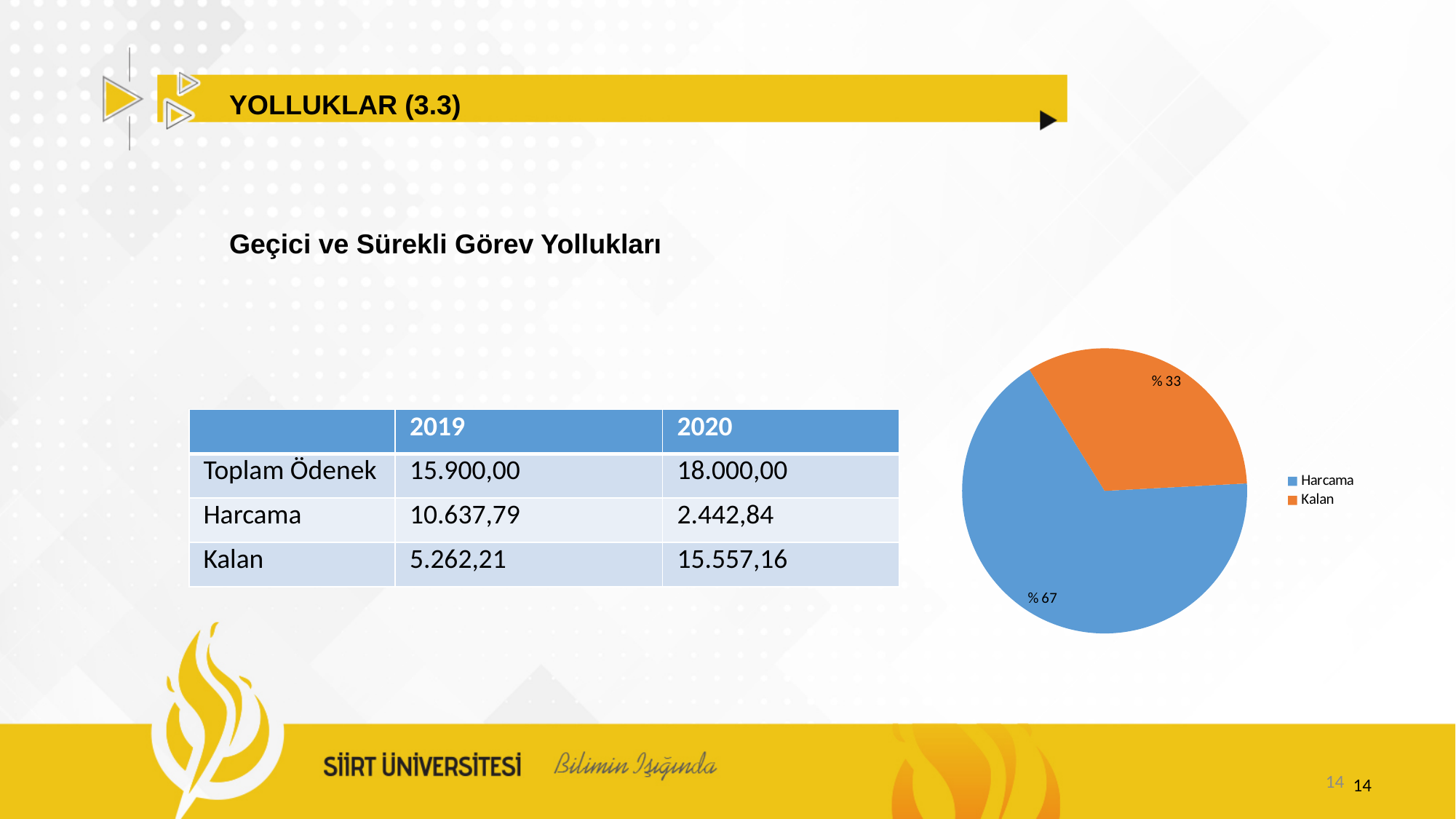
Which colour represents Kalan in the pie chart? orange How many entries does the pie chart's legend list? 2 Which slice of the pie chart is the largest? Harcama What is the difference in percentage points between the Harcama and Kalan slices of the pie chart? 34 What kind of chart is shown on the slide? pie chart What share of the pie chart does Kalan take? % 33 Which slice of the pie chart is the smallest? Kalan Which colour represents Harcama in the pie chart? blue How many slices does the pie chart have? 2 What share of the pie chart does Harcama take? % 67 In the pie chart, which is larger, Harcama or Kalan? Harcama